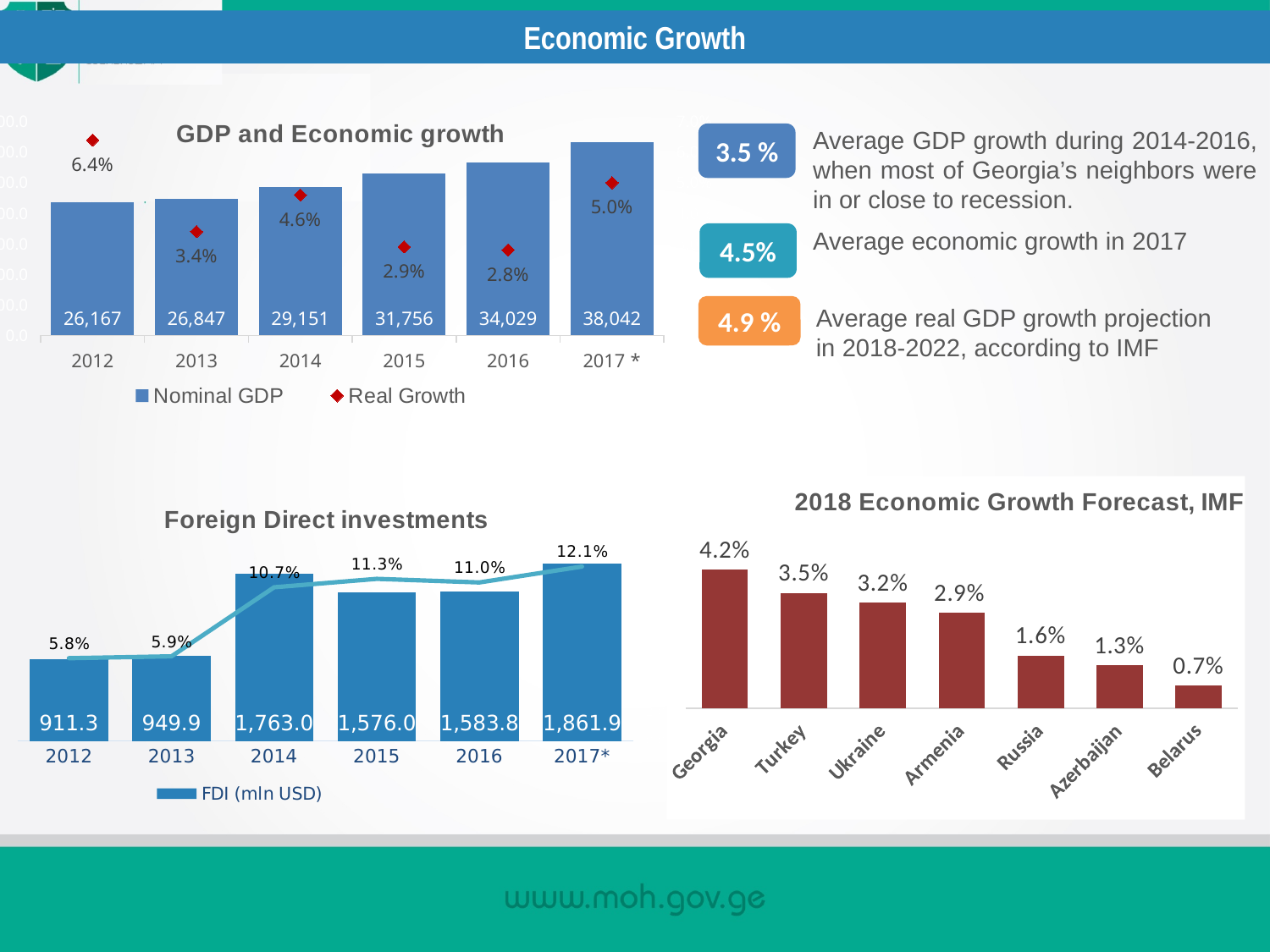
In the 'GDP and Economic growth' chart, do the Nominal GDP values rise or fall from 2012 to 2017 *? rise In the 'GDP and Economic growth' chart, what is the Real Growth value for 2012? 6.4% In the '2018 Economic Growth Forecast, IMF' chart, how many countries are shown? 7 In the '2018 Economic Growth Forecast, IMF' chart, what is the difference between the values for Georgia and Belarus? 3.5% In the 'Foreign Direct investments' chart, is the FDI value for 2015 larger or smaller than the value for 2016? smaller In the 'GDP and Economic growth' chart, which year has the lowest Real Growth? 2016 In the '2018 Economic Growth Forecast, IMF' chart, what is the value for Armenia? 2.9% In the 'GDP and Economic growth' chart, how many series does the legend list? 2 In the 'GDP and Economic growth' chart, what is the difference in Nominal GDP between 2017 * and 2016? 4,013 In the 'Foreign Direct investments' chart, what is the FDI (mln USD) value for 2014? 1,763.0 In the 'Foreign Direct investments' chart, which year has the highest FDI (mln USD) value? 2017* In the 'GDP and Economic growth' chart, what is the Nominal GDP value for 2015? 31,756